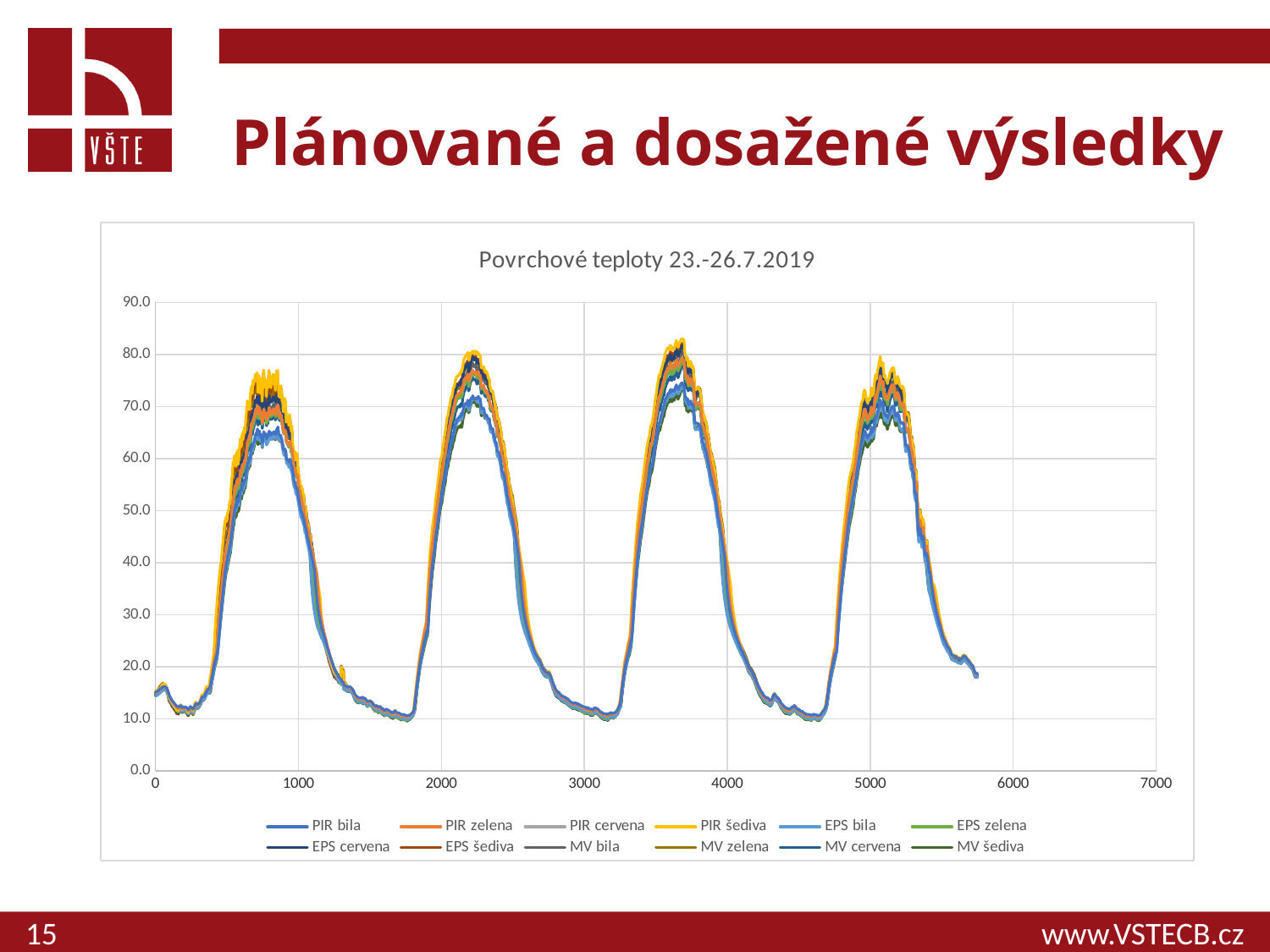
Is the value of the lines at x = 3000 greater or less than 30.0? less What is the title of the chart? Povrchové teploty 23.-26.7.2019 How many series does the chart's legend list? 12 How many daily temperature peaks are visible on the chart? 4 What kind of chart is shown on the slide? line chart Which series reaches the highest peak values on the chart? PIR šediva Is the lowest value reached by the lines on the chart greater or less than 20.0? less Is the peak of the second daily cycle (around x = 2200) greater or less than 60.0? greater Is the peak of the fourth daily cycle (around x = 5100) higher or lower than the peak of the third daily cycle (around x = 3700)? lower What is the maximum value shown on the vertical axis? 90.0 Which legend entry is drawn in yellow? PIR šediva